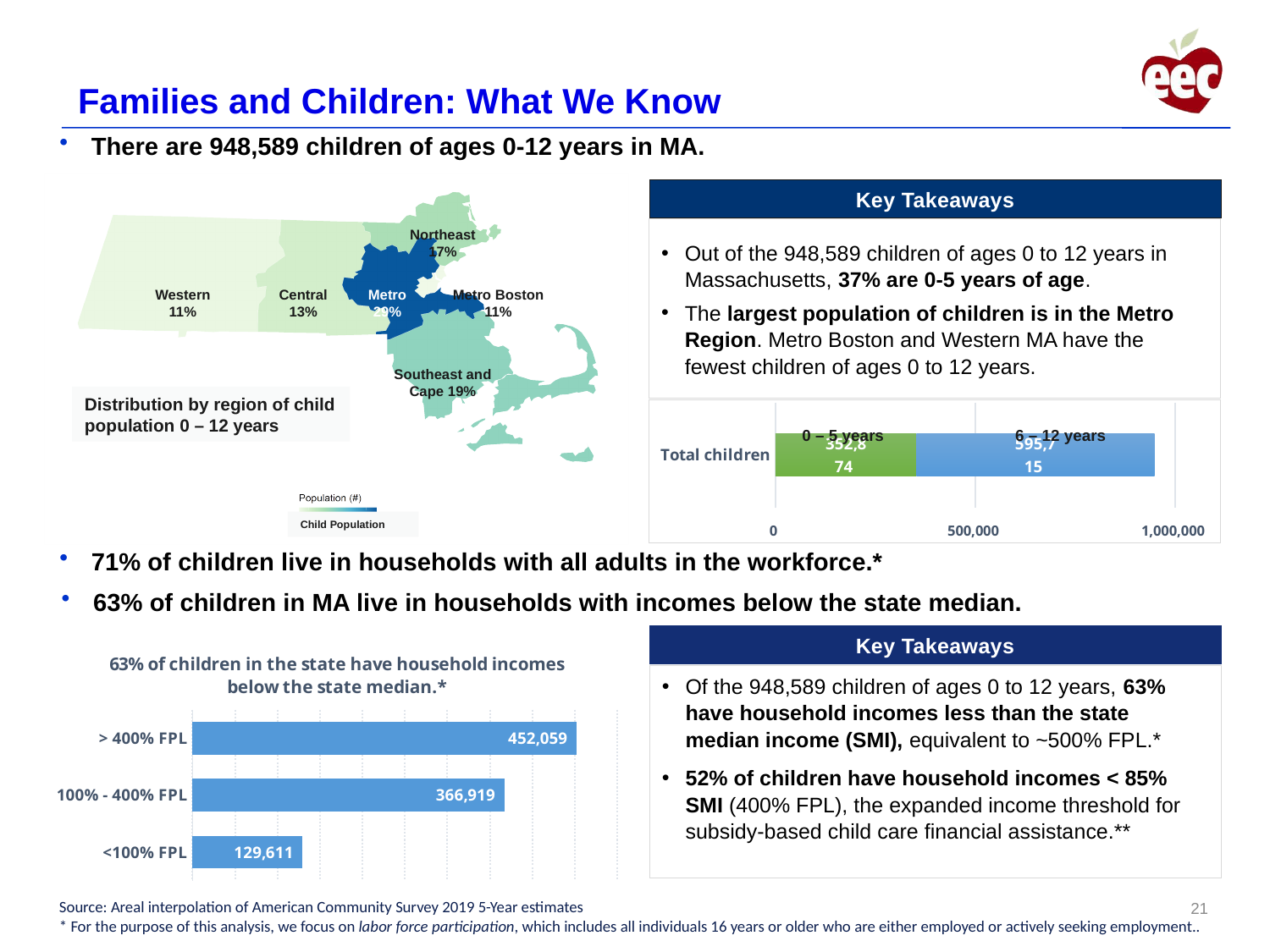
In the bottom-left chart titled "63% of children in the state have household incomes below the state median.*", how many categories are shown? 3 In the "Total children" chart on the right side of the slide, what is the total of the stacked bar? 948,589 What kind of chart is the bottom-left chart titled "63% of children in the state have household incomes below the state median.*"? Bar chart In the bottom-left chart titled "63% of children in the state have household incomes below the state median.*", which category has the highest value? > 400% FPL In the bottom-left chart titled "63% of children in the state have household incomes below the state median.*", what is the difference between the values for > 400% FPL and 100% - 400% FPL? 85,140 In the "Total children" chart on the right side of the slide, which segment is larger, 0 – 5 years or 6 – 12 years? 6 – 12 years In the "Total children" chart on the right side of the slide, what is the value for 6 – 12 years? 595,715 In the bottom-left chart titled "63% of children in the state have household incomes below the state median.*", what is the value for 100% - 400% FPL? 366,919 In the bottom-left chart titled "63% of children in the state have household incomes below the state median.*", what is the value for <100% FPL? 129,611 In the "Total children" chart on the right side of the slide, what is the value for 0 – 5 years? 352,874 In the bottom-left chart titled "63% of children in the state have household incomes below the state median.*", which category has the lowest value? <100% FPL In the bottom-left chart titled "63% of children in the state have household incomes below the state median.*", what is the value for > 400% FPL? 452,059